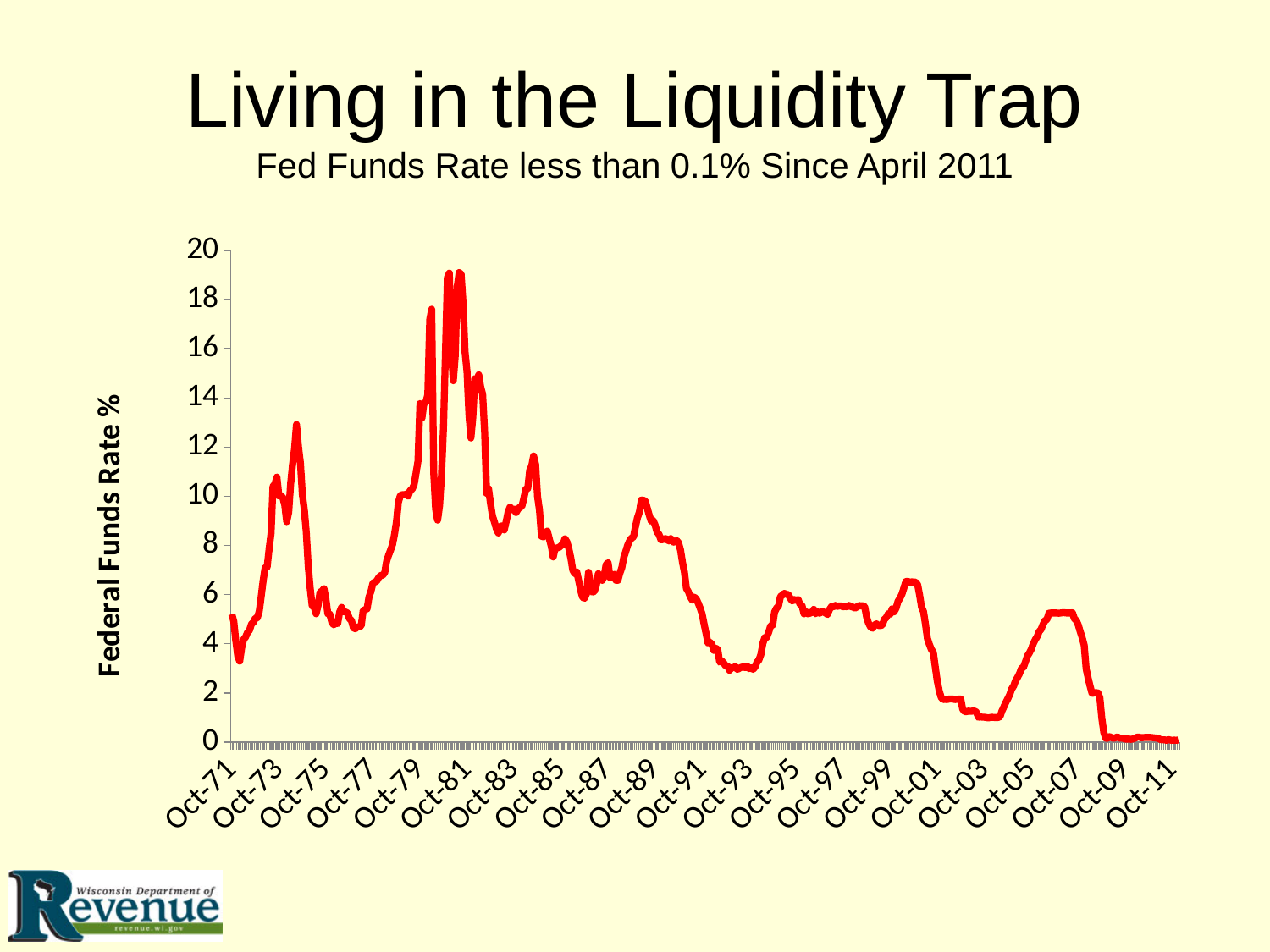
How many date labels are shown along the horizontal axis? 21 Does the Federal Funds Rate rise or fall between Oct-07 and Oct-09? fall What is the subtitle shown under the chart's main title? Fed Funds Rate less than 0.1% Since April 2011 Is the Federal Funds Rate at Oct-11 greater or less than 2? less Around which labelled date does the Federal Funds Rate reach its highest point? Oct-81 What kind of chart is shown on the slide? line chart Is the Federal Funds Rate at Oct-07 greater or less than 4? greater Which is larger, the Federal Funds Rate at Oct-73 or at Oct-03? Oct-73 What is the highest value shown on the vertical axis? 20 What is the label on the vertical axis of the chart? Federal Funds Rate % Around which labelled date is the Federal Funds Rate at its lowest? Oct-11